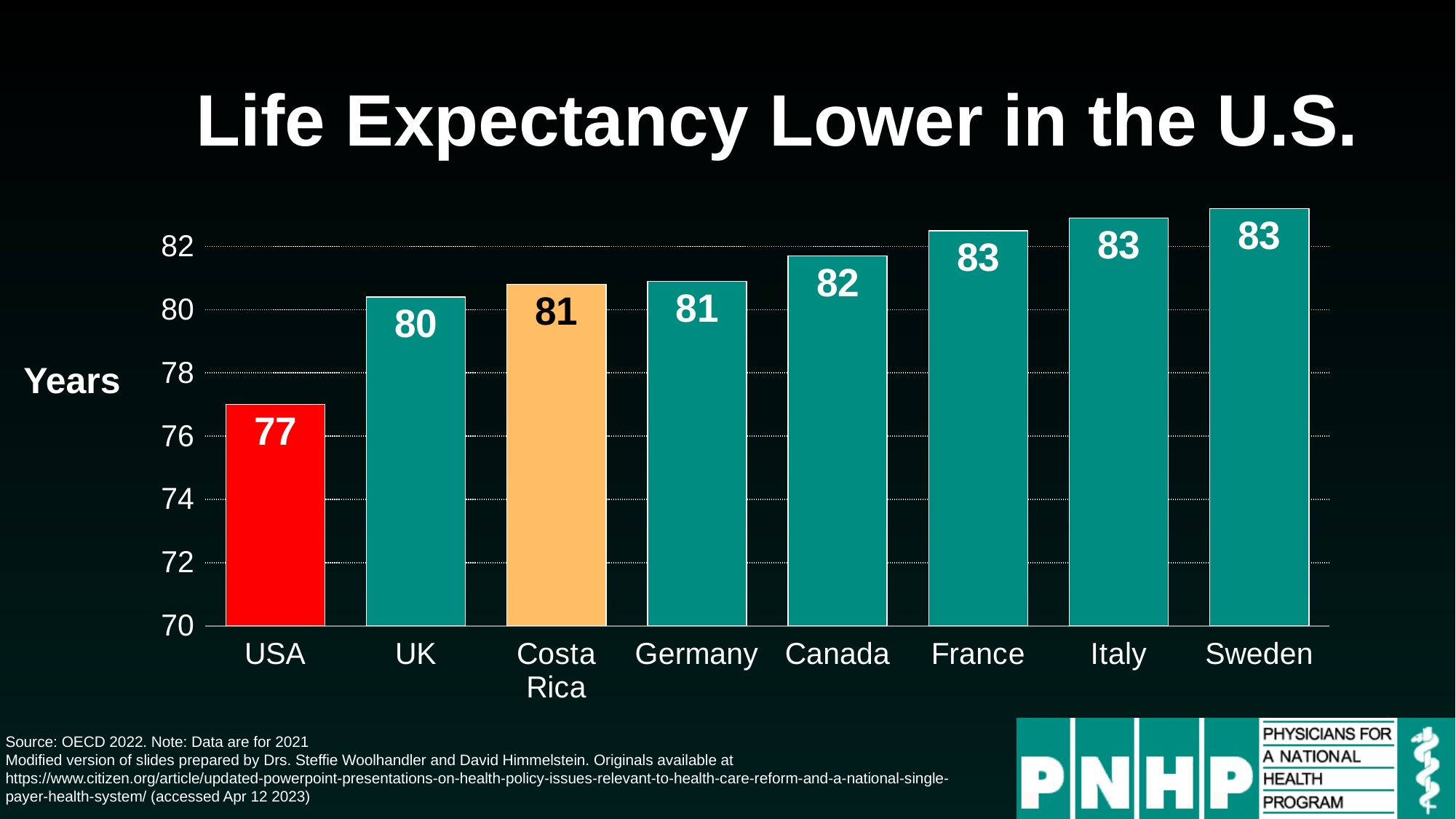
Which has a higher life expectancy value, Canada or the UK? Canada How many countries are shown on the chart? 8 What is the difference between the life expectancy values for Sweden and the USA? 6 What is the life expectancy value shown for Canada? 82 What is the life expectancy value shown for the USA? 77 What is the difference between the life expectancy values for the UK and the USA? 3 Is the value for the USA greater or less than 78? less Do the life expectancy values generally rise or fall from left to right across the chart? Rise What colour is the bar for the USA? Red What is the life expectancy value shown for Costa Rica? 81 What kind of chart is shown on the slide? Bar chart Which country has the lowest life expectancy on the chart? USA